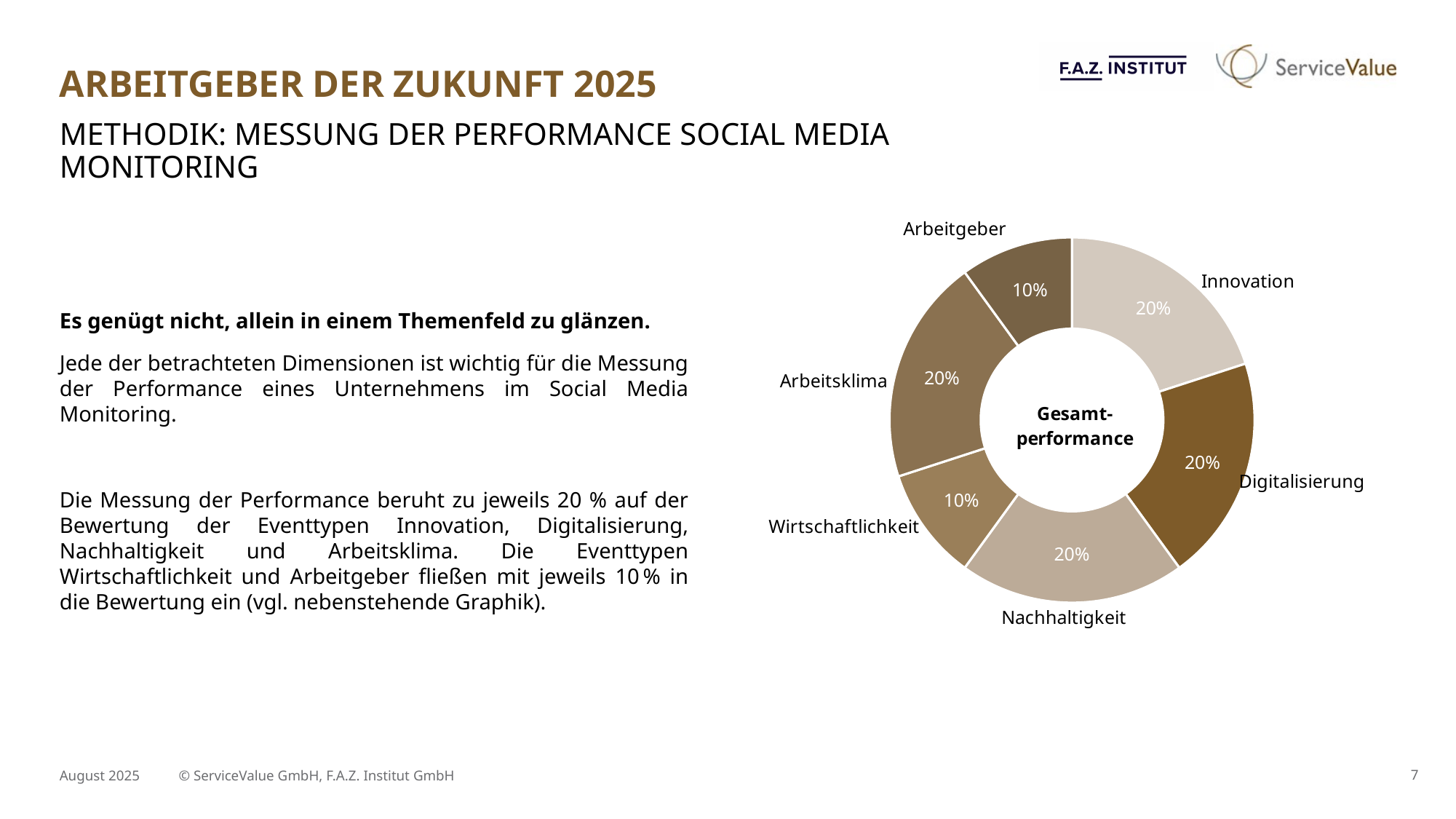
What label is shown in the centre of the donut chart? Gesamt-performance What share does Nachhaltigkeit have in the chart? 20% How many slices does the chart have? 6 What share does Digitalisierung have in the chart? 20% What share does Wirtschaftlichkeit have in the chart? 10% What share does Arbeitgeber have in the chart? 10% What share does Innovation have in the Gesamtperformance chart? 20% What share does Arbeitsklima have in the chart? 20% Which slices have the smallest share in the chart? Wirtschaftlichkeit and Arbeitgeber What kind of chart is shown on the slide? Pie (donut) chart Which is larger, the share of Innovation or the share of Arbeitgeber? Innovation What is the difference between the share of Arbeitsklima and the share of Wirtschaftlichkeit? 10 percentage points